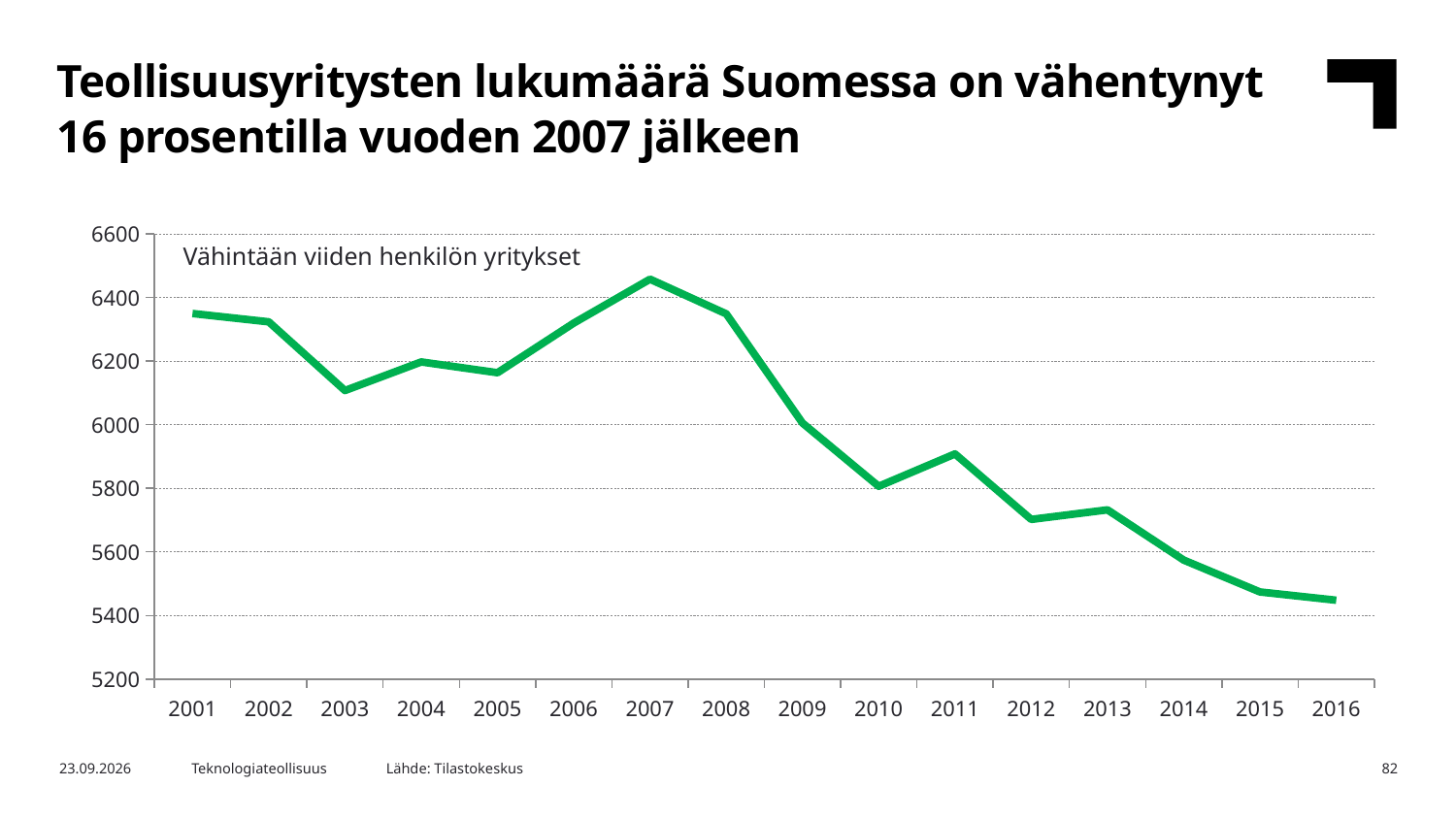
Does the number of companies overall rise or fall from 2007 to 2016? fall What text label is shown inside the plot area describing the companies counted? Vähintään viiden henkilön yritykset Is the value for 2012 greater or less than 5800? less Is the value for 2011 greater or less than 5800? greater Which year has the larger value, 2003 or 2004? 2004 Which year has the larger value, 2010 or 2011? 2011 What kind of chart is shown on the slide? Line chart Is the value for 2007 greater or less than 6400? greater How many years are plotted on the x axis? 16 In which year is the number of industrial companies highest? 2007